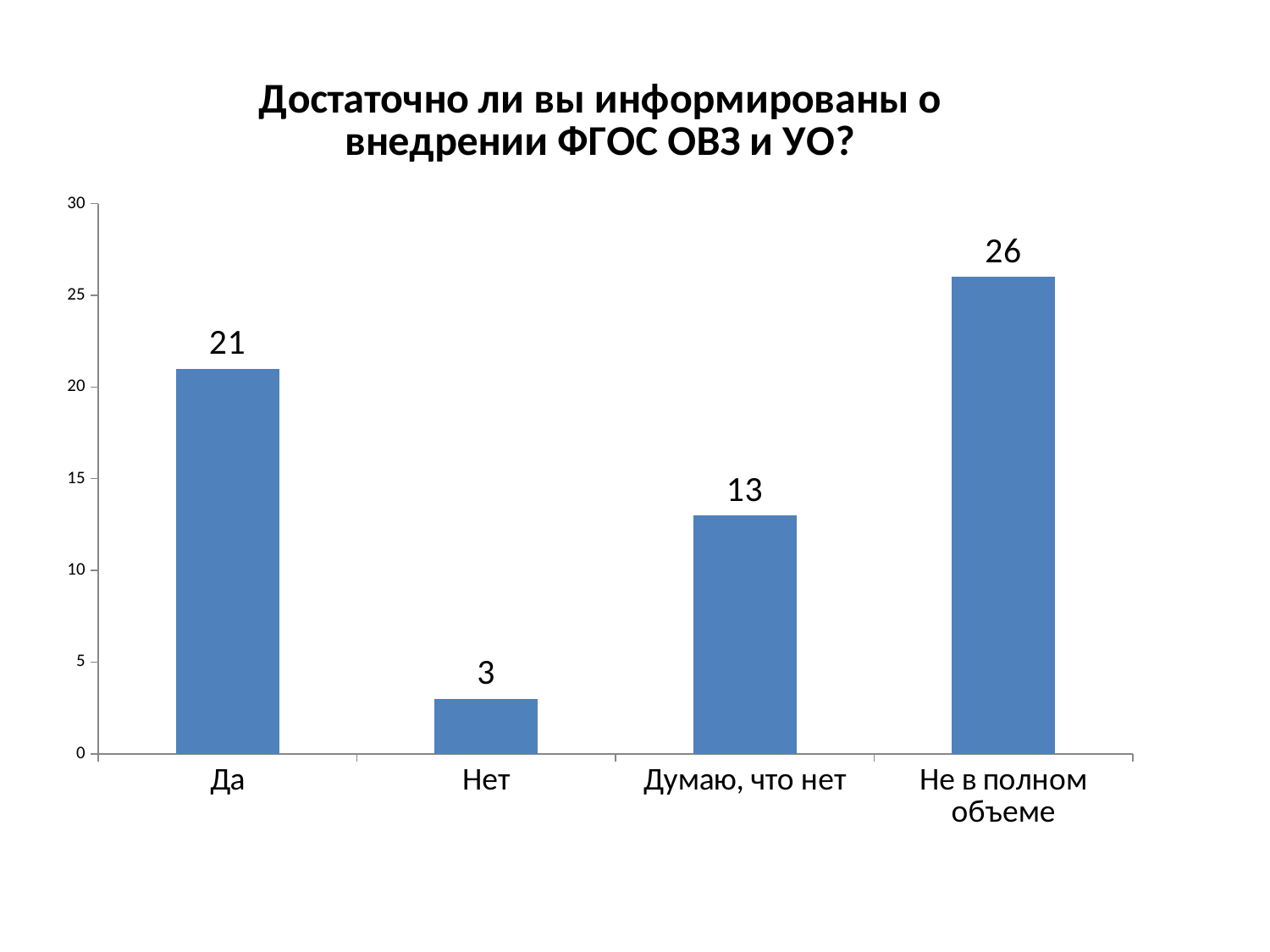
What is the difference between the values for "Не в полном объеме" and "Да"? 5 What is the value for "Не в полном объеме"? 26 What is the value for "Да"? 21 Which category has the highest value? Не в полном объеме What kind of chart is shown on the slide? bar chart Is the value for "Думаю, что нет" greater or less than 15? less Which is larger, the value for "Да" or the value for "Думаю, что нет"? Да What is the value for "Нет"? 3 How many categories are shown on the x axis? 4 What is the title of the chart? Достаточно ли вы информированы о внедрении ФГОС ОВЗ и УО? Which category has the lowest value? Нет What is the value for "Думаю, что нет"? 13